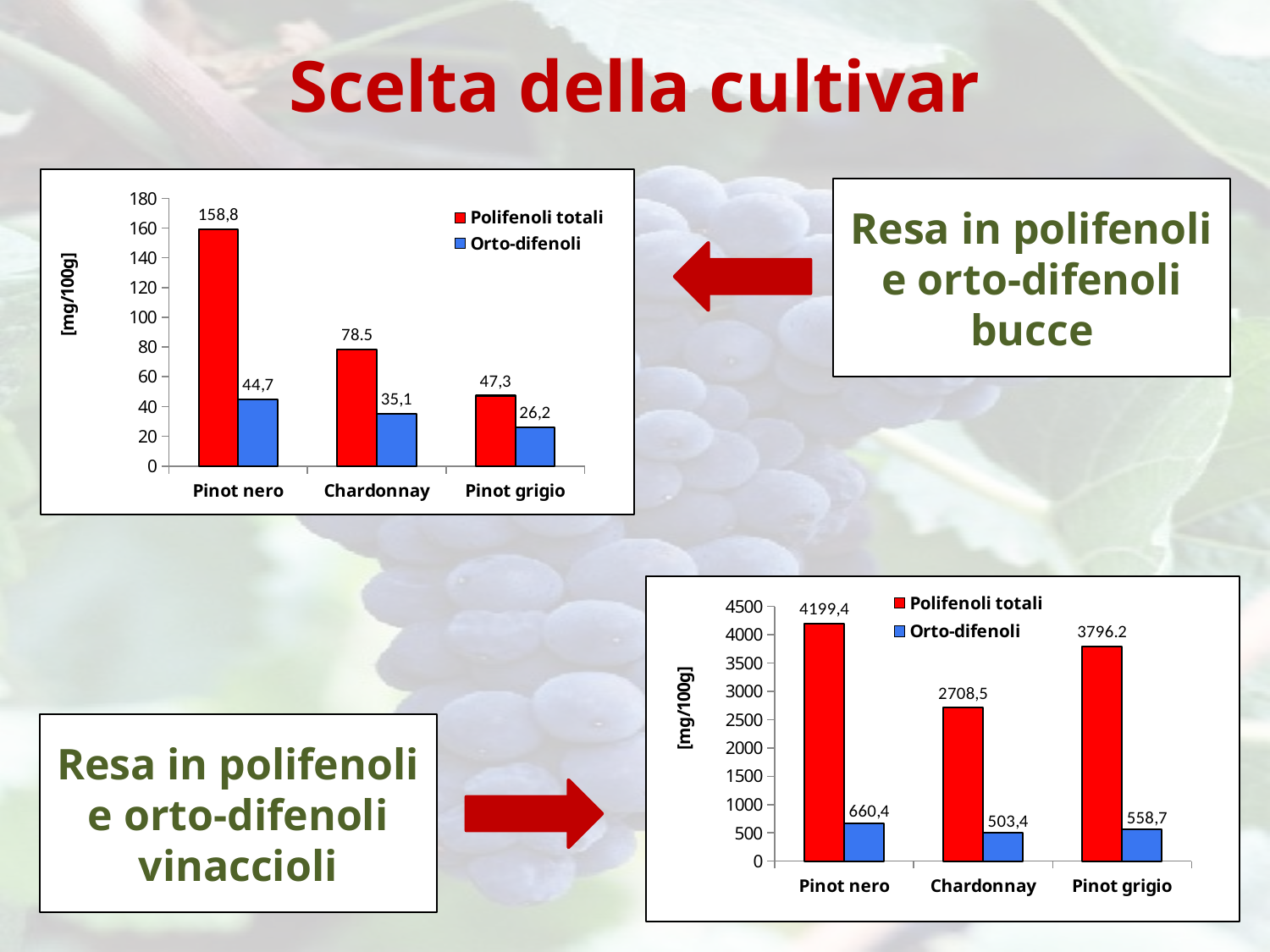
In the bottom-right chart, what is the value of Polifenoli totali for Chardonnay? 2708,5 In the top-left chart, do the Orto-difenoli values rise or fall from Pinot nero to Pinot grigio? fall In the top-left chart, what is the difference between Polifenoli totali and Orto-difenoli for Pinot nero? 114,1 In the top-left chart, how many series does the legend list? 2 In the bottom-right chart, which is larger, the Orto-difenoli value for Pinot nero or for Chardonnay? Pinot nero In the bottom-right chart, which cultivar has the highest Polifenoli totali value? Pinot nero In the top-left chart, what is the value of Polifenoli totali for Pinot nero? 158,8 In the bottom-right chart, what is the value of Orto-difenoli for Pinot grigio? 558,7 In the top-left chart, what is the value of Orto-difenoli for Chardonnay? 35,1 In the bottom-right chart, what is the difference in Polifenoli totali between Pinot nero and Chardonnay? 1490,9 What type of chart is the bottom-right chart? bar chart In the top-left chart, which cultivar has the lowest Polifenoli totali value? Pinot grigio